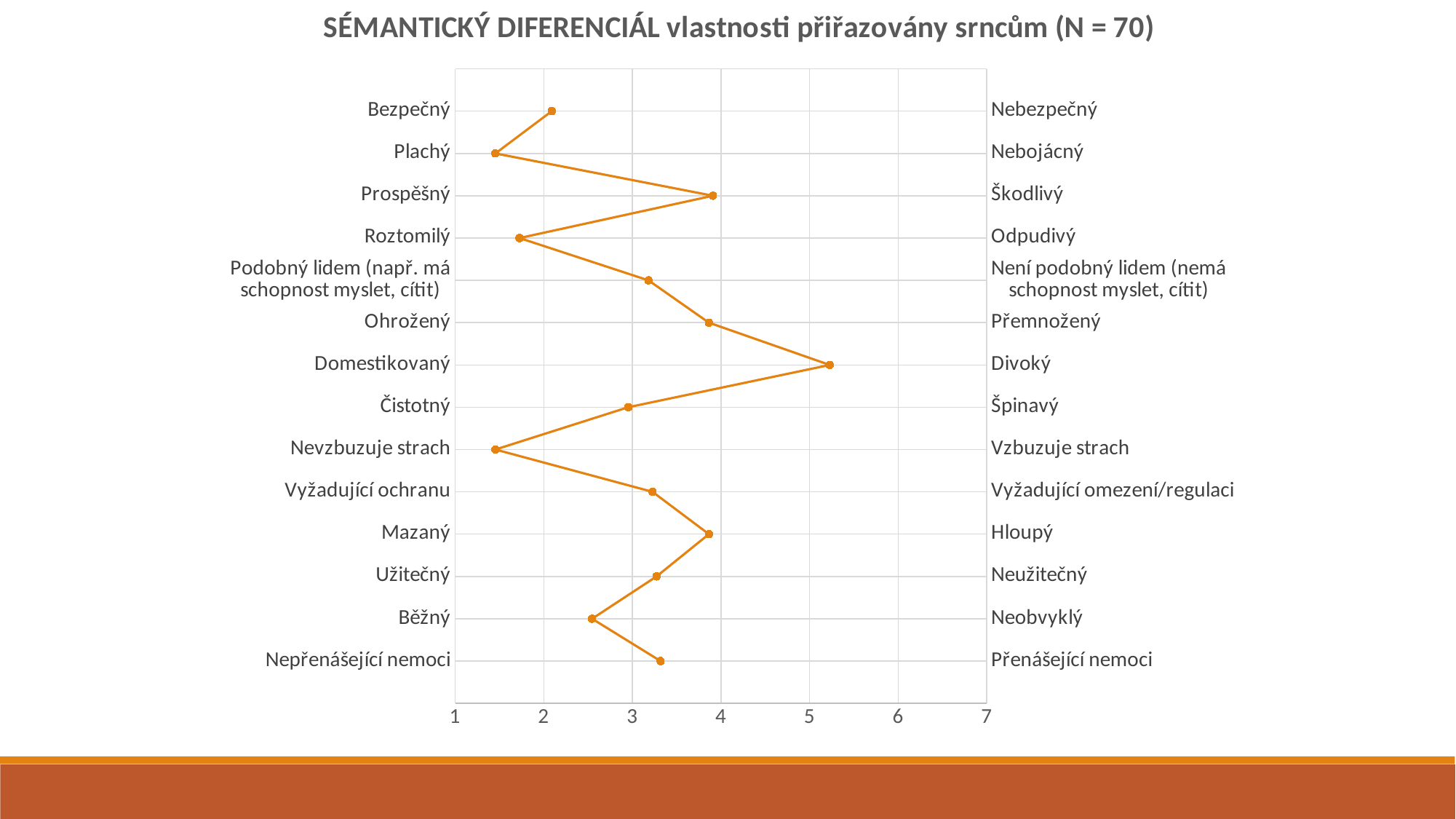
Is the value for Prospěšný – Škodlivý greater or less than 3? greater Which has the larger value: Domestikovaný – Divoký or Čistotný – Špinavý? Domestikovaný – Divoký Which attribute pair has the highest plotted value? Domestikovaný – Divoký Is the value for Bezpečný – Nebezpečný greater or less than 3? less Is the value for Domestikovaný – Divoký greater or less than 4? greater How many attribute pairs (rows) are plotted on the chart? 14 Which has the larger value: Bezpečný – Nebezpečný or Prospěšný – Škodlivý? Prospěšný – Škodlivý What kind of chart is shown on the slide? line chart What is the range of the horizontal axis? 1 to 7 What sample size (N) is stated in the chart title? 70